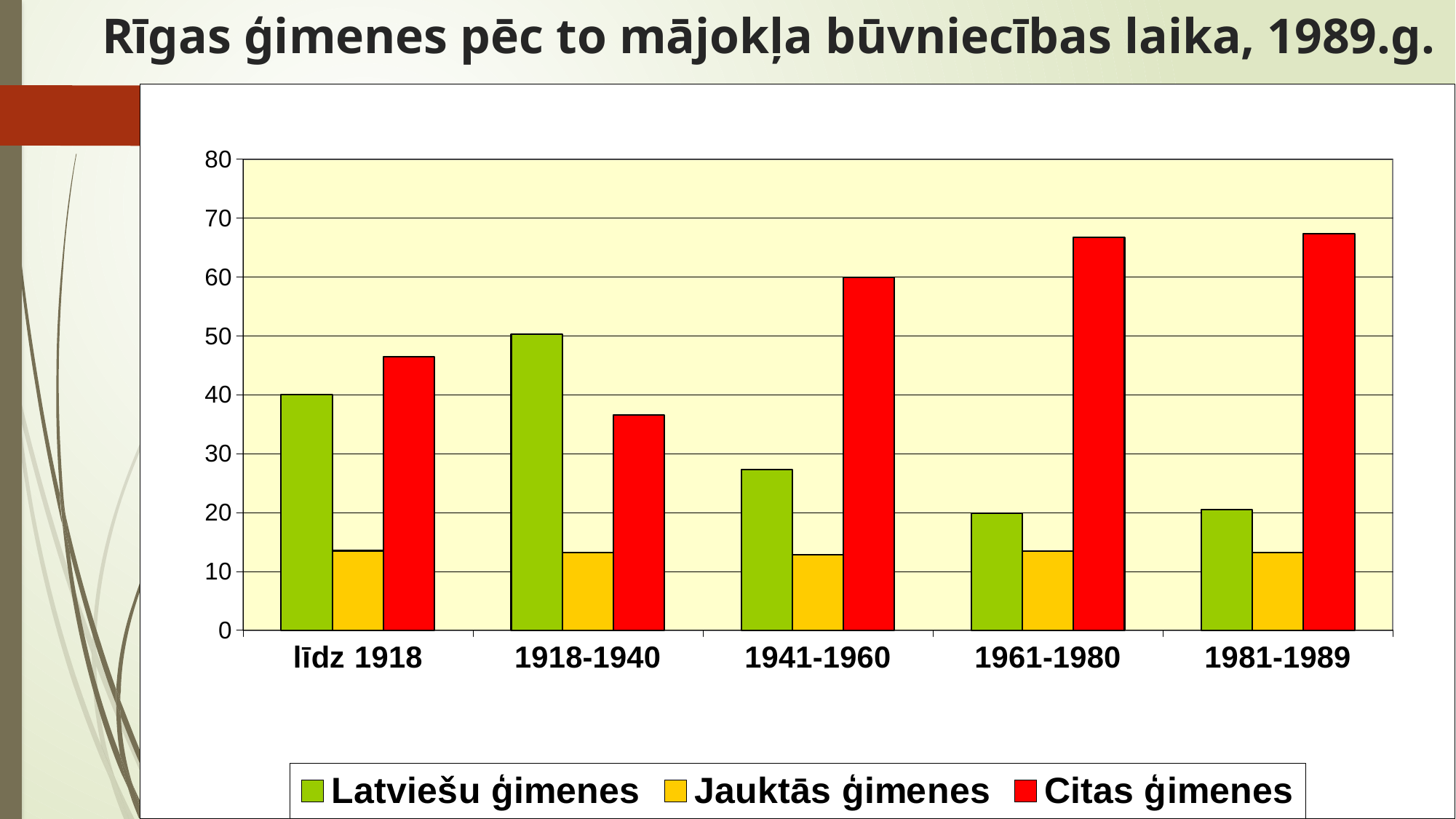
Which period has the highest value for Latviešu ģimenes? 1918-1940 How many series does the legend list? 3 How many time-period categories are shown on the x axis? 5 In the period līdz 1918, which is larger: Latviešu ģimenes or Citas ģimenes? Citas ģimenes Which period has the lowest value for Citas ģimenes? 1918-1940 What kind of chart is shown on the slide? bar chart In the period 1918-1940, which is larger: Latviešu ģimenes or Citas ģimenes? Latviešu ģimenes Is the value for Citas ģimenes in 1918-1940 greater or less than 40? less What colour represents Citas ģimenes in the legend? red Is the value for Citas ģimenes in 1961-1980 greater or less than 60? greater Is the value for Latviešu ģimenes in 1941-1960 greater or less than 30? less What is the title of the slide? Rīgas ģimenes pēc to mājokļa būvniecības laika, 1989.g.